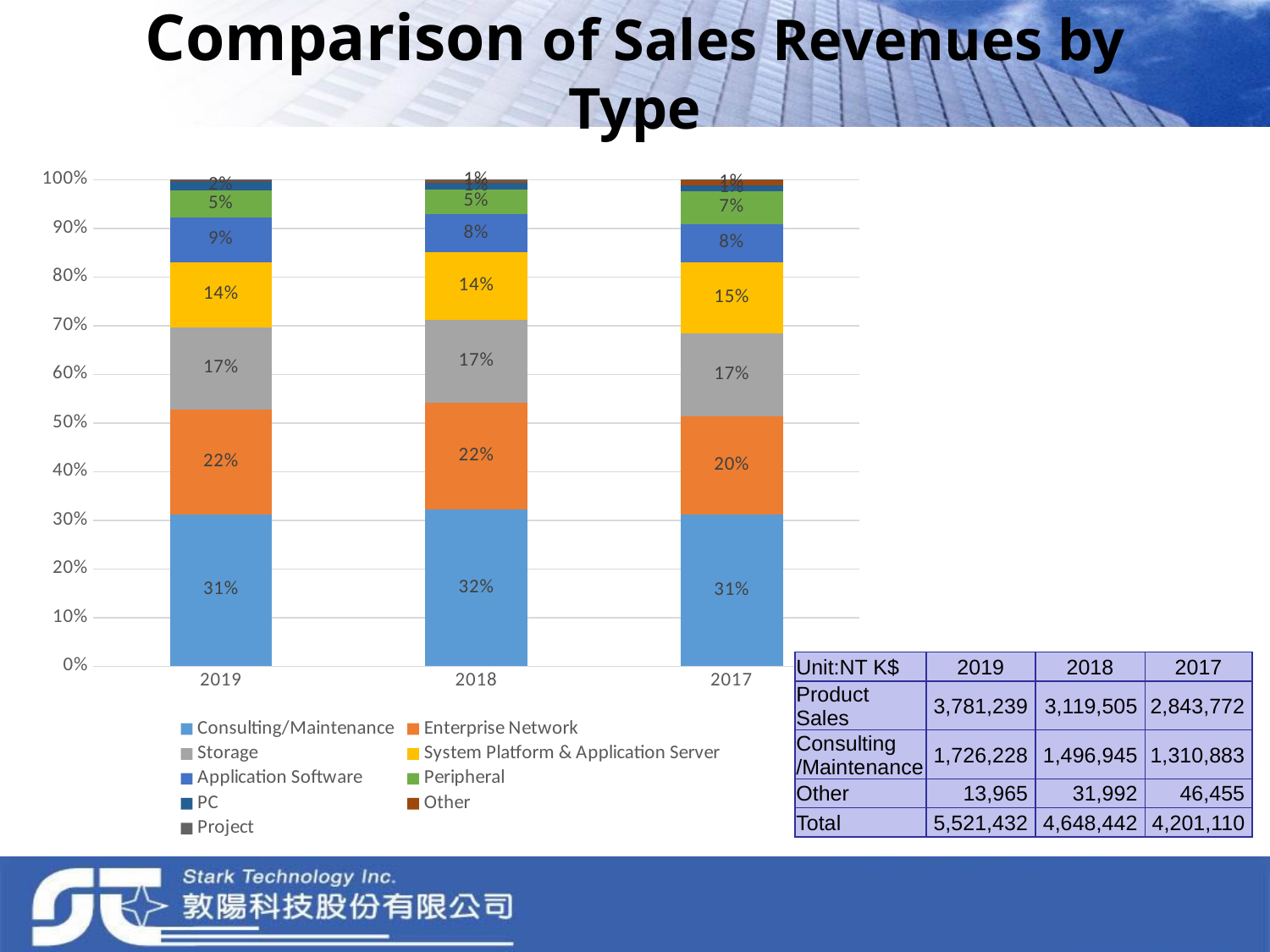
By how many percentage points does the Peripheral share in 2017 exceed that in 2019? 2 percentage points What is the Application Software share in 2019? 9% What type of chart is shown on the slide? Stacked bar chart What percentage of sales revenue did Consulting/Maintenance account for in 2019? 31% In which year was the Consulting/Maintenance share the highest? 2018 Which year had the larger Enterprise Network share, 2019 or 2017? 2019 What is the value for System Platform & Application Server in 2018? 14% What share did Enterprise Network have in 2017? 20% How many years are shown on the x axis of the chart? 3 What is the Peripheral share in 2017? 7% How many series does the legend list? 9 What is the Storage share in 2018? 17%